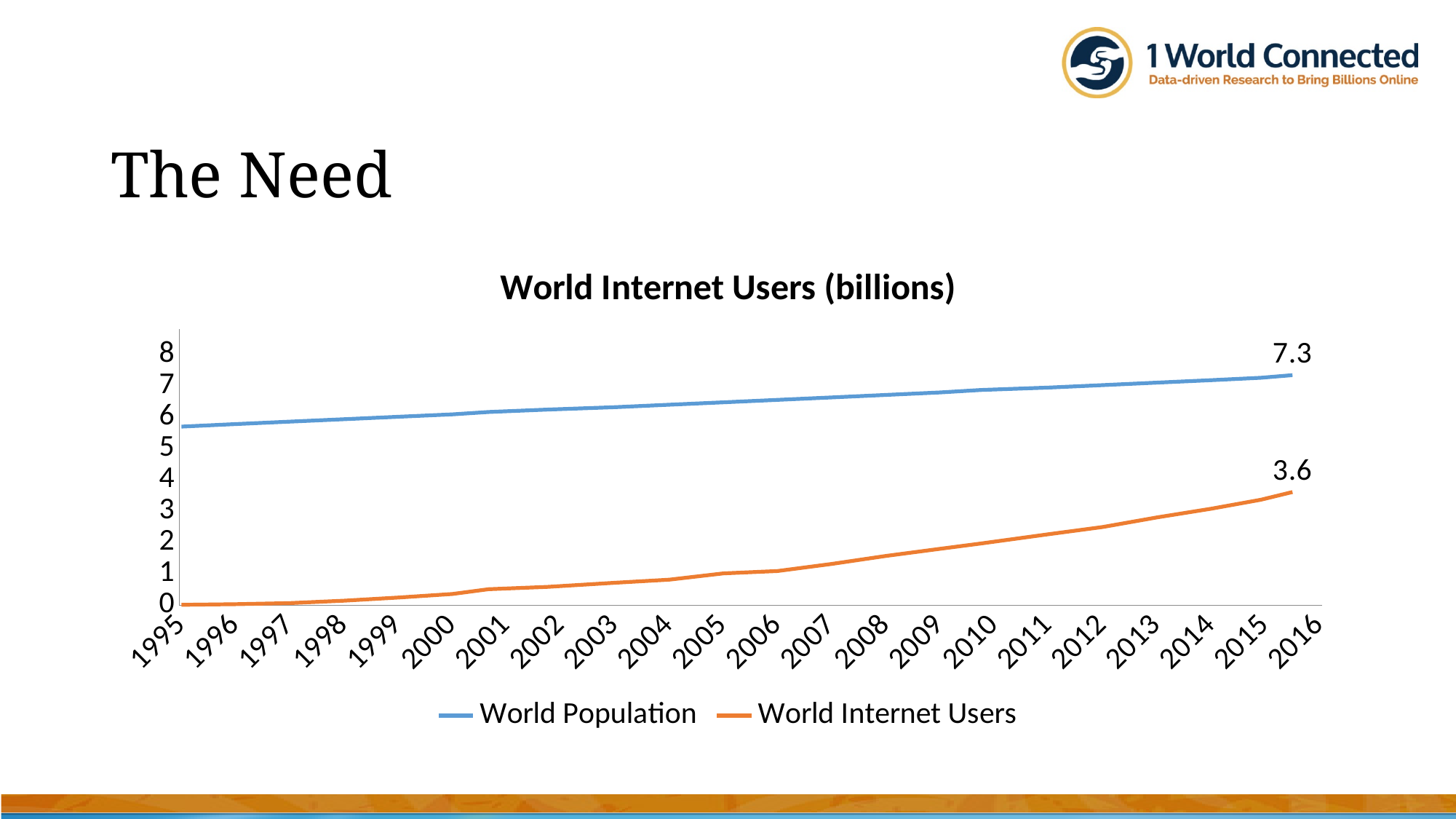
Is the value for World Population in 2010 greater or less than 6? greater How many series does the legend list? 2 What is the difference between the labelled end values of World Population (7.3) and World Internet Users (3.6)? 3.7 Which series has the higher values throughout the chart, World Population or World Internet Users? World Population How many years are labelled on the x axis? 22 Is the value for World Internet Users in 2000 greater or less than 1? less What kind of chart is shown on the slide? line chart What value is labelled at the end of the World Population line? 7.3 What value is labelled at the end of the World Internet Users line? 3.6 Does the World Internet Users line rise or fall from 1995 to 2016? rise What is the title of the chart? World Internet Users (billions) Which colour is used for the World Internet Users line? orange